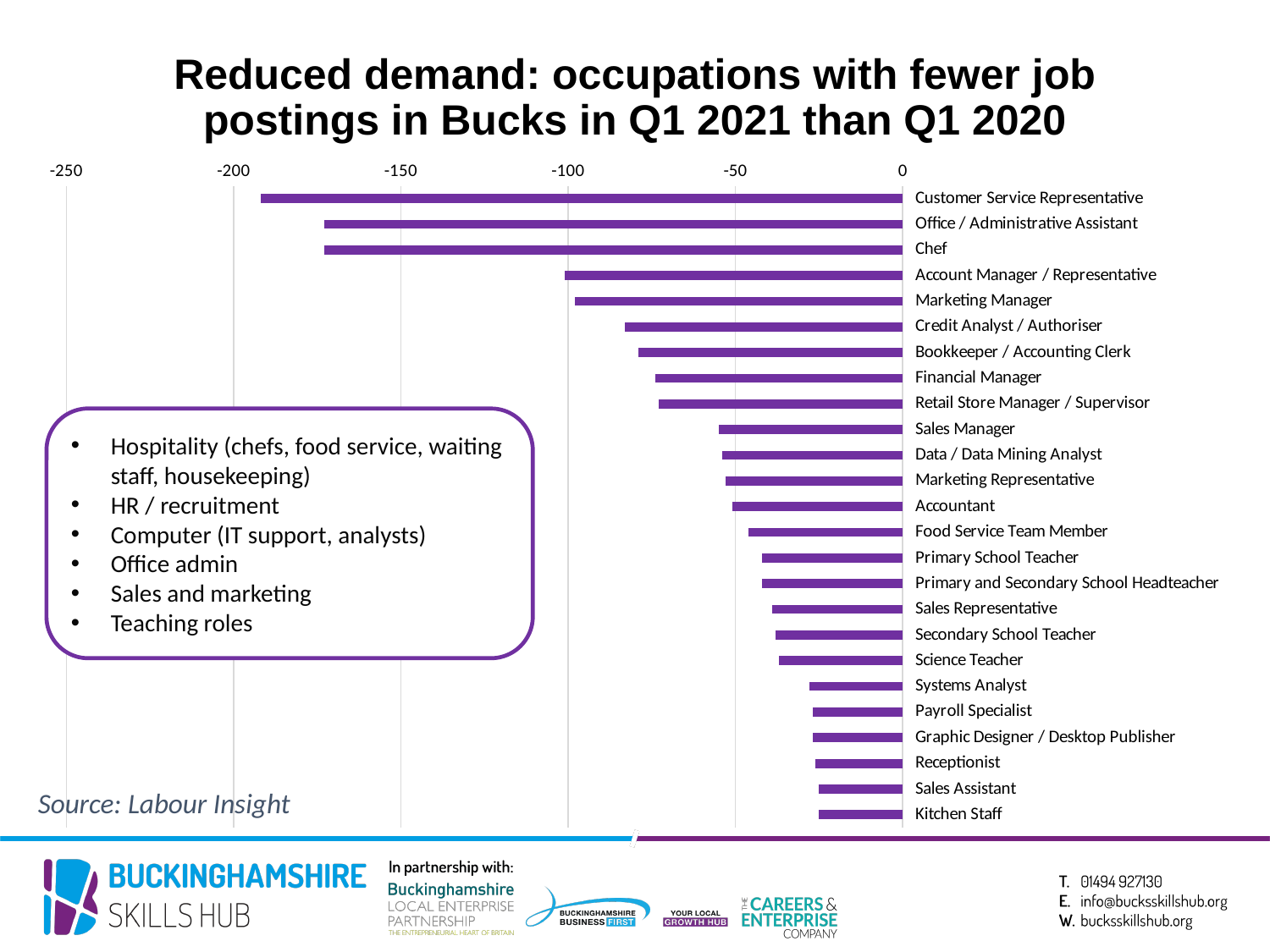
How many occupations are listed in the chart? 25 Is the value for Primary School Teacher greater or less than -50? greater What is the title of the chart? Reduced demand: occupations with fewer job postings in Bucks in Q1 2021 than Q1 2020 Which has the larger reduction in job postings, Credit Analyst / Authoriser or Sales Manager? Credit Analyst / Authoriser What is the source cited for the chart data? Labour Insight What kind of chart is shown on the slide? bar chart Is the value for Credit Analyst / Authoriser greater or less than -100? greater Which occupation shows the largest reduction in job postings (the longest bar)? Customer Service Representative Is the value for Kitchen Staff greater or less than -50? greater Which has the larger reduction in job postings, Customer Service Representative or Chef? Customer Service Representative